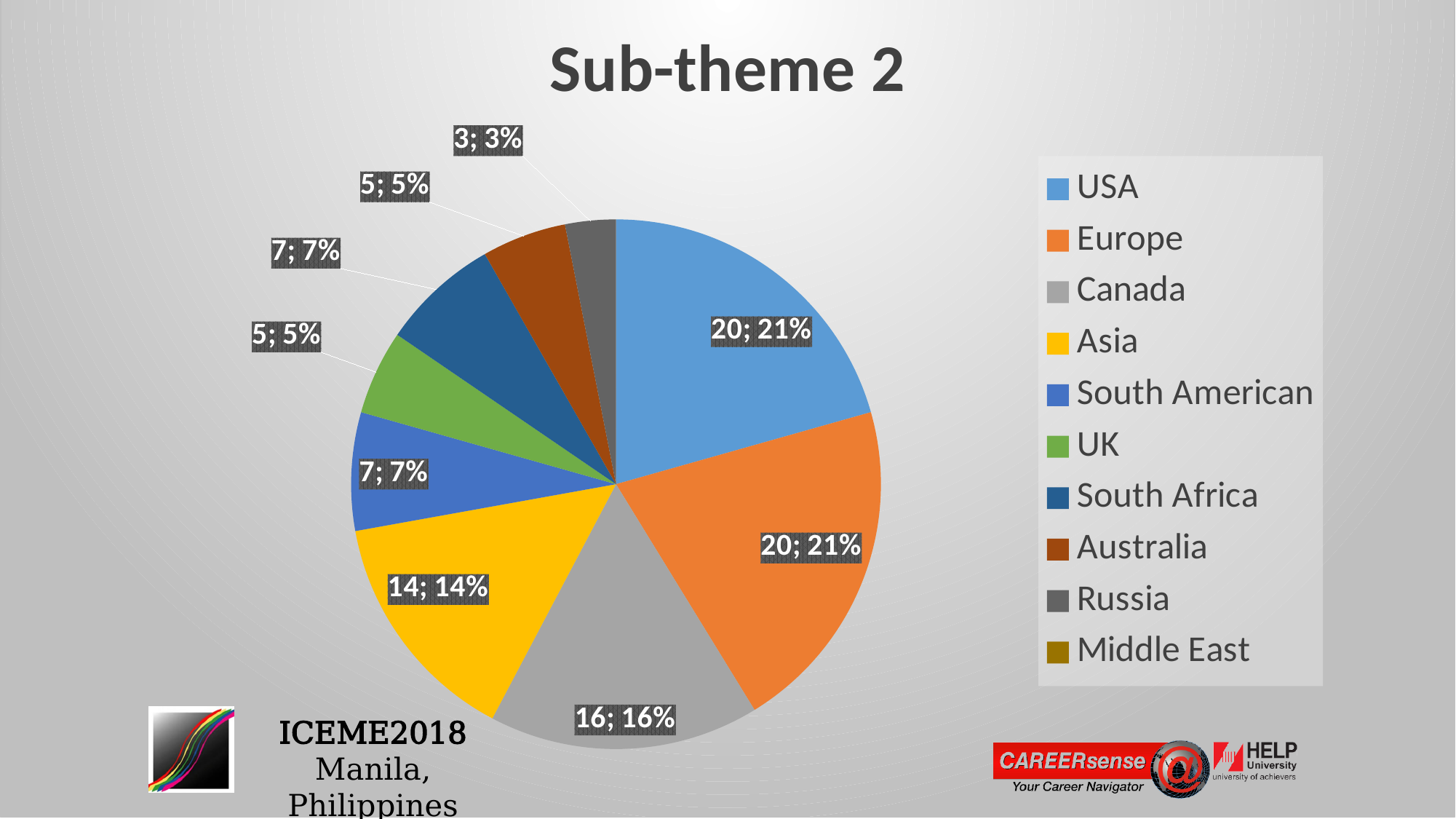
What is the title of the chart? Sub-theme 2 Which is larger, the value for Canada or the value for Asia? Canada What percentage share does Asia have in the pie chart? 14% Which is larger, the value for South Africa or the value for UK? South Africa What is the data label shown for the Russia slice? 3; 3% What value is shown for Australia? 5 Which labelled slice of the pie is the smallest? Russia How many entries does the legend list? 10 What value is shown for Canada in the pie chart? 16 What kind of chart is shown on the slide? Pie chart What is the difference between the value for USA and the value for Asia? 6 What share of the pie does Europe represent? 21%